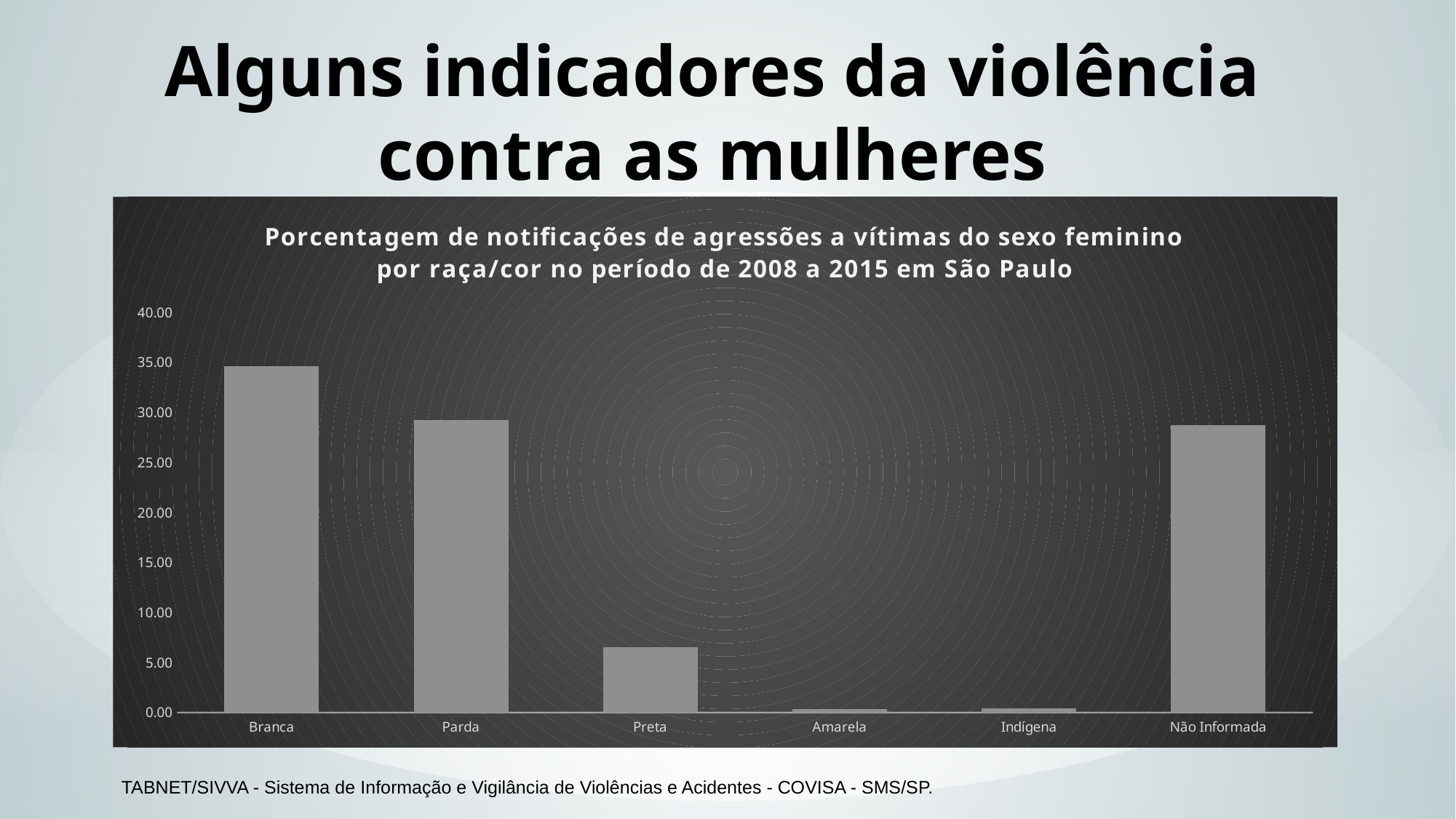
Which is larger, the value for Branca or the value for Parda? Branca Is the value for Branca greater or less than 30? greater Is the value for Preta greater or less than 10? less What period does the chart title say the data covers? 2008 a 2015 Is the value for Amarela greater or less than 5? less Which category has the highest bar in the chart? Branca What kind of chart is shown on the slide? bar chart Which is larger, the value for Preta or the value for Não Informada? Não Informada How many race/colour categories are shown on the x axis of the chart? 6